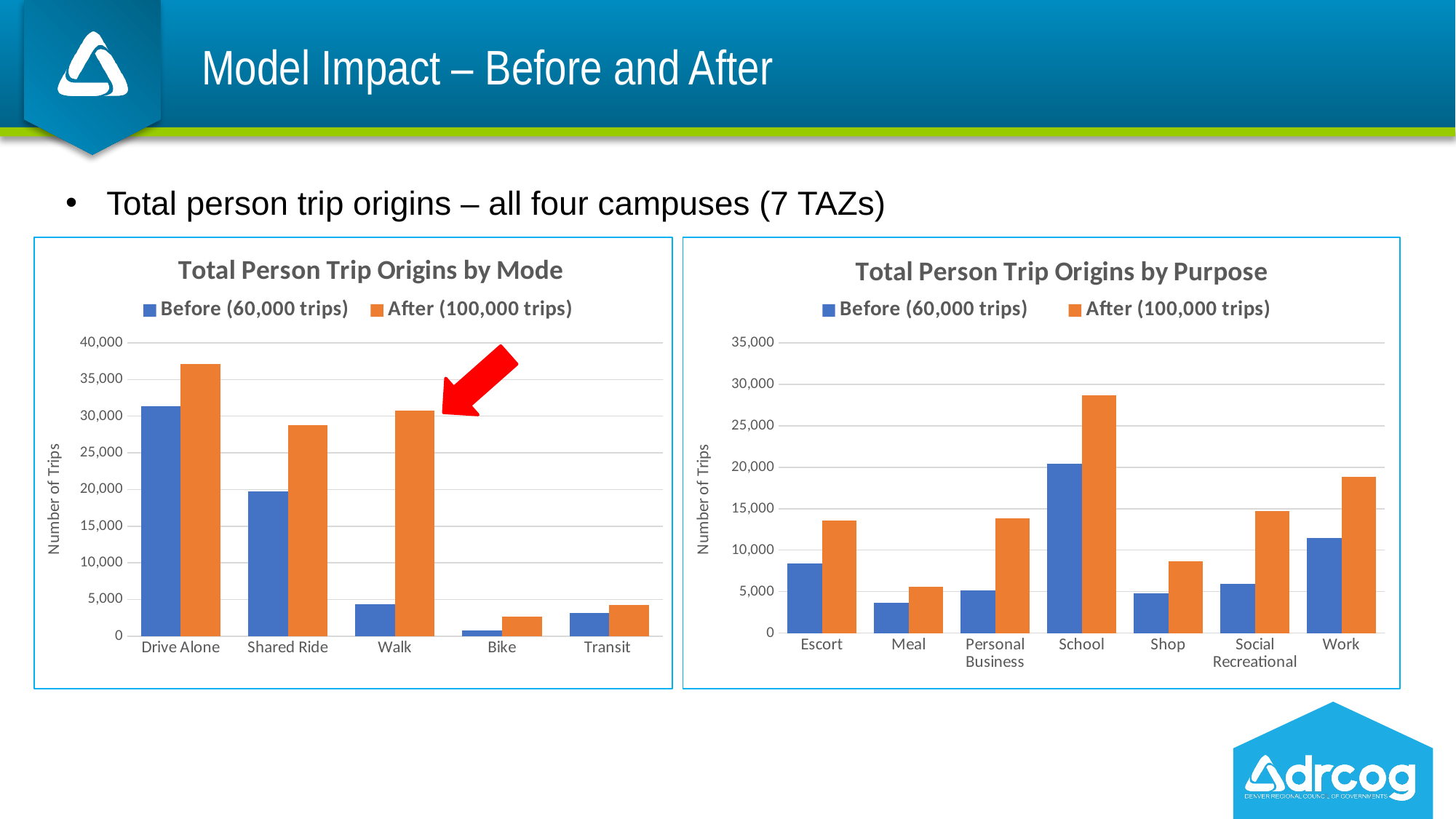
What is the y-axis title of the 'Total Person Trip Origins by Purpose' chart? Number of Trips In the 'Total Person Trip Origins by Mode' chart, how many mode categories are shown on the x axis? 5 In the 'Total Person Trip Origins by Purpose' chart, which purpose has the highest After (100,000 trips) value? School In the 'Total Person Trip Origins by Mode' chart, is the After (100,000 trips) value for Walk greater or less than 25,000? greater In the 'Total Person Trip Origins by Purpose' chart, is the Before (60,000 trips) value for Work greater or less than 15,000? less In the 'Total Person Trip Origins by Mode' chart, which is larger: the After (100,000 trips) value for Drive Alone or the After (100,000 trips) value for Shared Ride? Drive Alone In the 'Total Person Trip Origins by Purpose' chart, how many series does the legend list? 2 What kind of chart is the 'Total Person Trip Origins by Mode' chart? bar chart In the 'Total Person Trip Origins by Purpose' chart, which purpose has the lowest Before (60,000 trips) value? Meal In the 'Total Person Trip Origins by Purpose' chart, which is larger: the After (100,000 trips) value for Work or the After (100,000 trips) value for Social Recreational? Work In the 'Total Person Trip Origins by Mode' chart, which mode has the highest Before (60,000 trips) value? Drive Alone In the 'Total Person Trip Origins by Mode' chart, which mode has the lowest After (100,000 trips) value? Bike